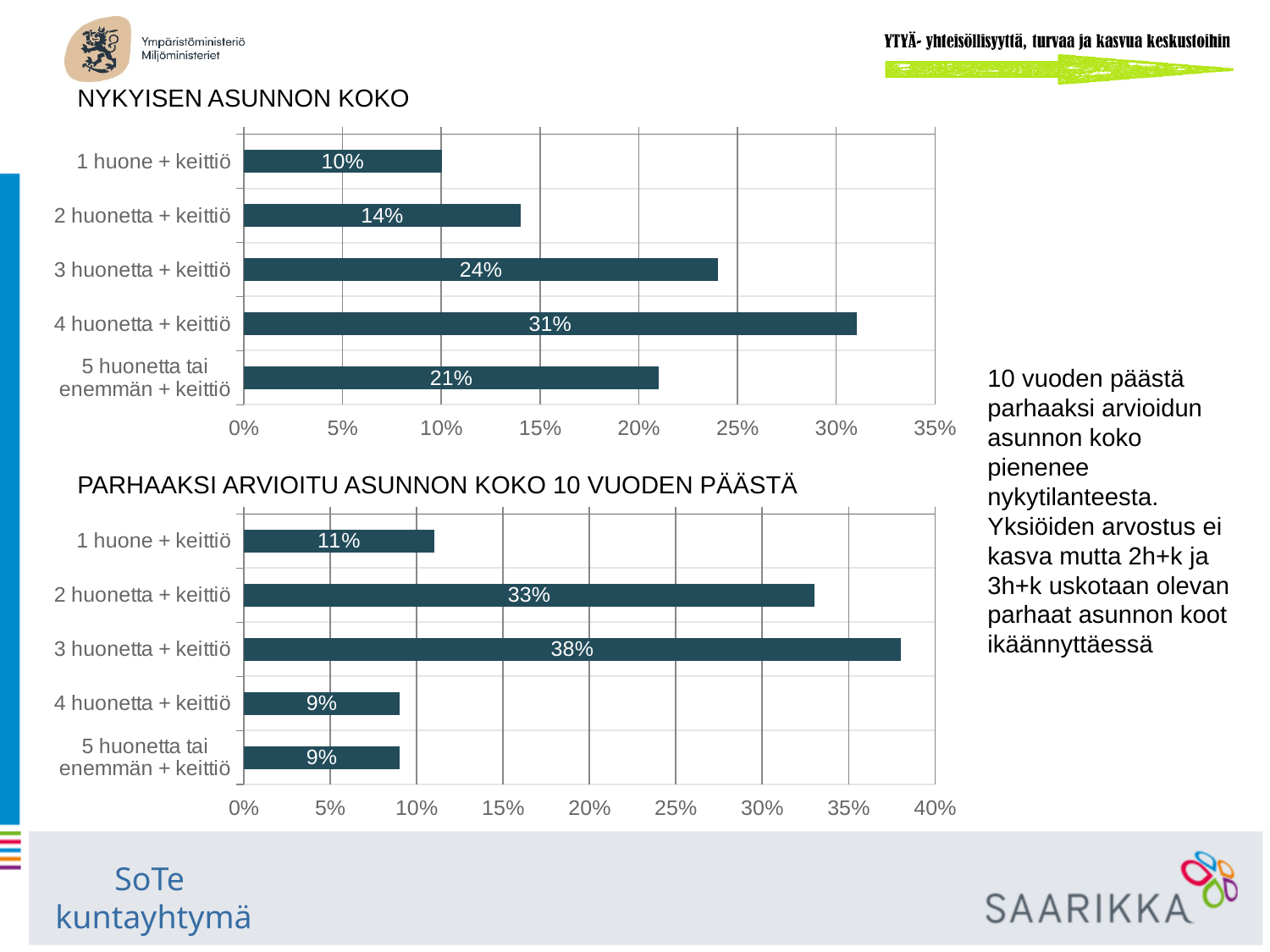
In the 'NYKYISEN ASUNNON KOKO' chart, which category has the lowest value? 1 huone + keittiö In the 'PARHAAKSI ARVIOITU ASUNNON KOKO 10 VUODEN PÄÄSTÄ' chart, what is the difference between '3 huonetta + keittiö' and '1 huone + keittiö'? 27% In the 'NYKYISEN ASUNNON KOKO' chart, which category has the highest value? 4 huonetta + keittiö What is the maximum value shown on the x axis of the 'PARHAAKSI ARVIOITU ASUNNON KOKO 10 VUODEN PÄÄSTÄ' chart? 40% In the 'PARHAAKSI ARVIOITU ASUNNON KOKO 10 VUODEN PÄÄSTÄ' chart, which is larger: '2 huonetta + keittiö' or '4 huonetta + keittiö'? 2 huonetta + keittiö In the 'NYKYISEN ASUNNON KOKO' chart, is the value for '5 huonetta tai enemmän + keittiö' greater or less than 15%? greater In the 'NYKYISEN ASUNNON KOKO' chart, what is the difference between '3 huonetta + keittiö' and '2 huonetta + keittiö'? 10% What kind of chart is the 'PARHAAKSI ARVIOITU ASUNNON KOKO 10 VUODEN PÄÄSTÄ' chart? Bar chart In the 'NYKYISEN ASUNNON KOKO' chart, what is the value for '4 huonetta + keittiö'? 31% How many categories are shown in the 'NYKYISEN ASUNNON KOKO' chart? 5 In the 'PARHAAKSI ARVIOITU ASUNNON KOKO 10 VUODEN PÄÄSTÄ' chart, which category has the highest value? 3 huonetta + keittiö In the 'PARHAAKSI ARVIOITU ASUNNON KOKO 10 VUODEN PÄÄSTÄ' chart, what is the value for '2 huonetta + keittiö'? 33%